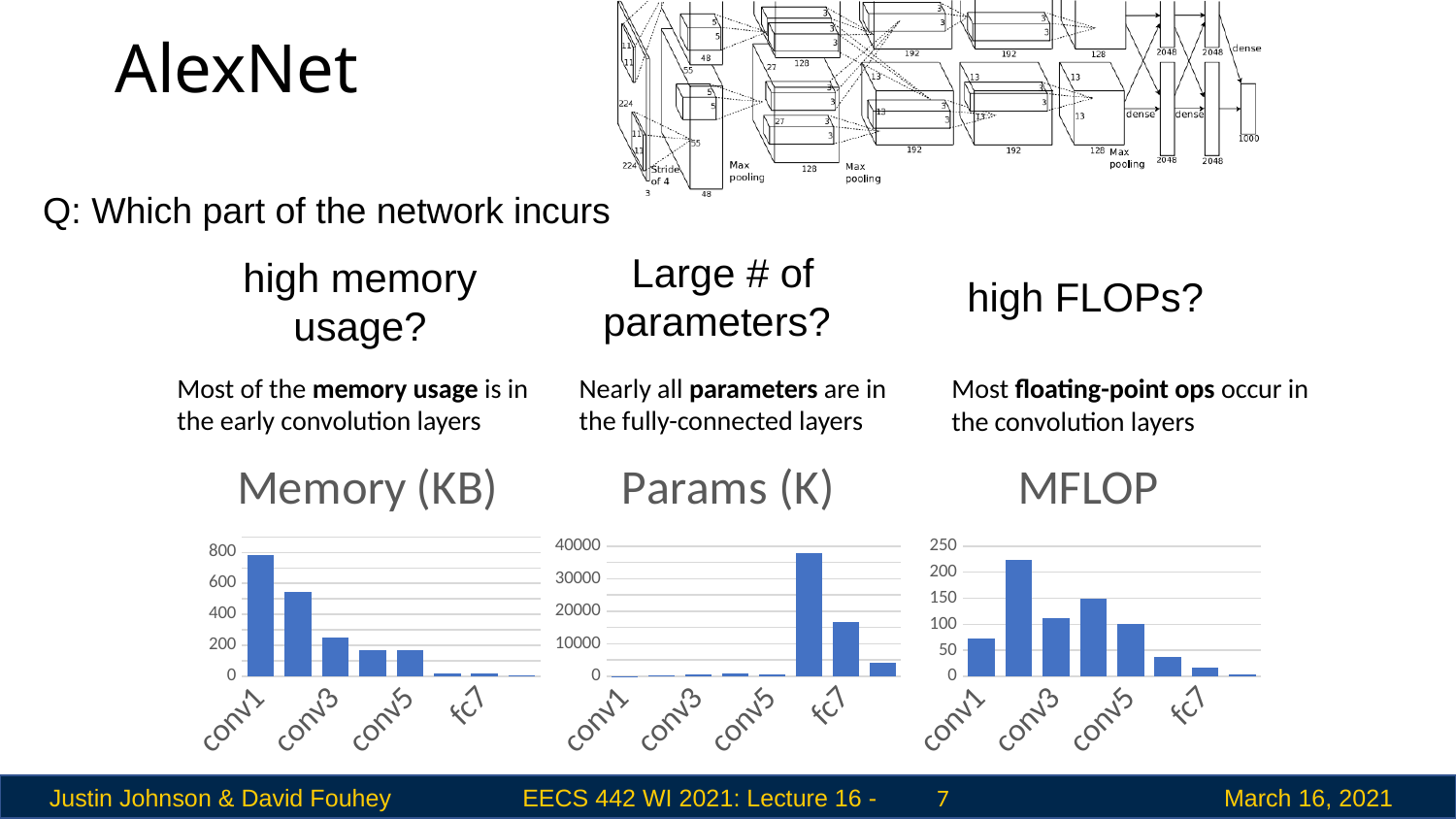
In the Memory (KB) chart, is the value for conv3 greater or less than 200? greater In the MFLOP chart, is the value for fc7 greater or less than 50? less In the Memory (KB) chart, is the value for conv1 greater or less than 600? greater What kind of chart is the Memory (KB) chart? bar chart In the MFLOP chart, which is larger, the value for conv1 or conv3? conv3 How many charts are shown on the slide? 3 In the Memory (KB) chart, which labeled layer has the highest memory usage? conv1 In the Memory (KB) chart, which is larger, the value for conv1 or conv3? conv1 In the Memory (KB) chart, do the values generally rise or fall from conv1 to fc7? fall